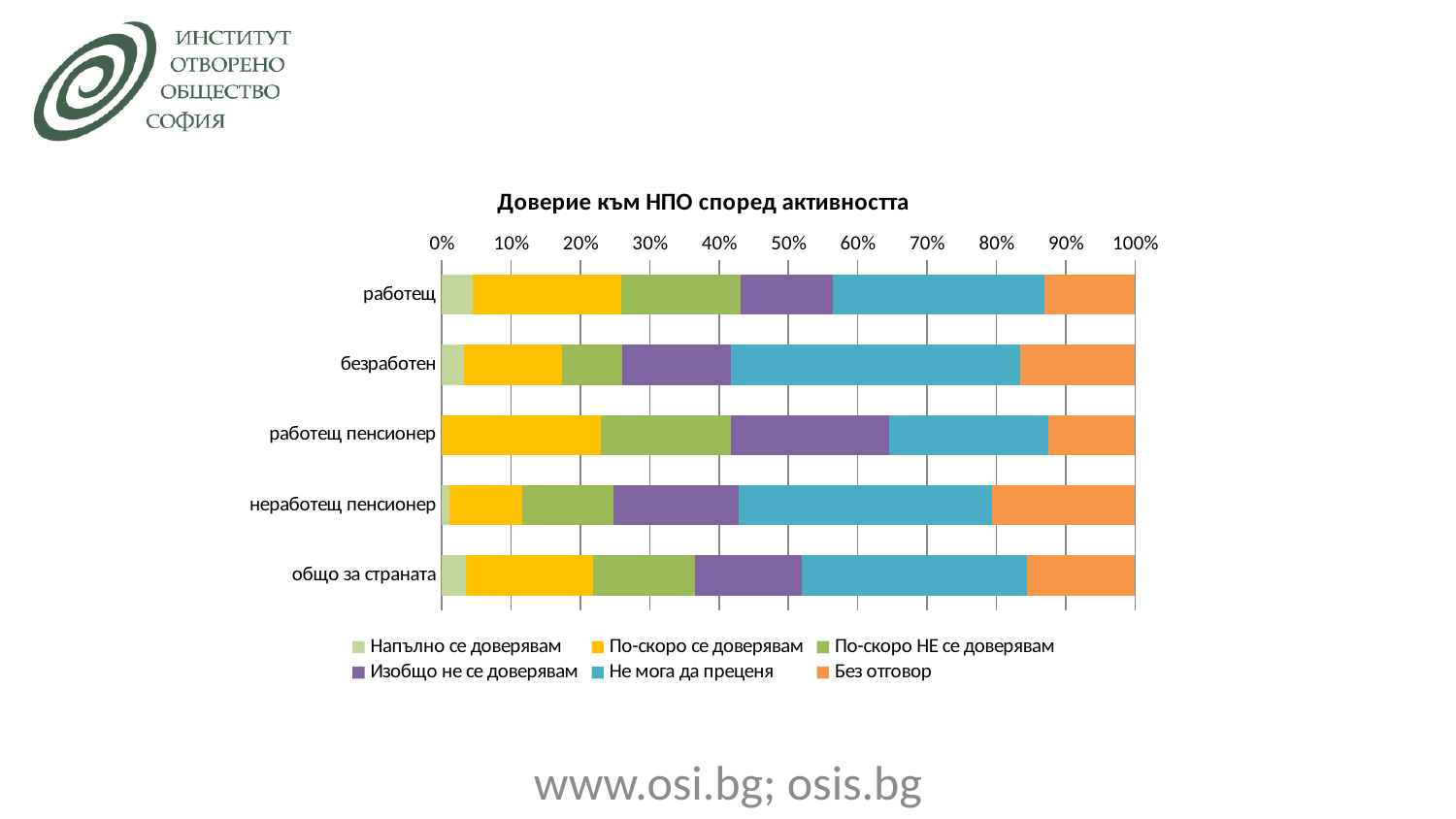
Is the value of 'Напълно се доверявам' for 'работещ' greater or less than 10%? less How many series does the legend list? 6 What is the title of the chart? Доверие към НПО според активността Is the value of 'Не мога да преценя' for 'безработен' greater or less than 30%? greater Is the value of 'Без отговор' for 'неработещ пенсионер' greater or less than 10%? greater What kind of chart is shown on the slide? stacked bar chart How many categories are shown on the vertical axis of the chart? 5 Which category has a larger 'По-скоро се доверявам' segment: 'работещ пенсионер' or 'неработещ пенсионер'? работещ пенсионер Which category has a larger 'Не мога да преценя' segment: 'безработен' or 'работещ пенсионер'? безработен Which category has a larger 'Изобщо не се доверявам' segment: 'работещ пенсионер' or 'работещ'? работещ пенсионер Which series is shown in orange in the chart? Без отговор